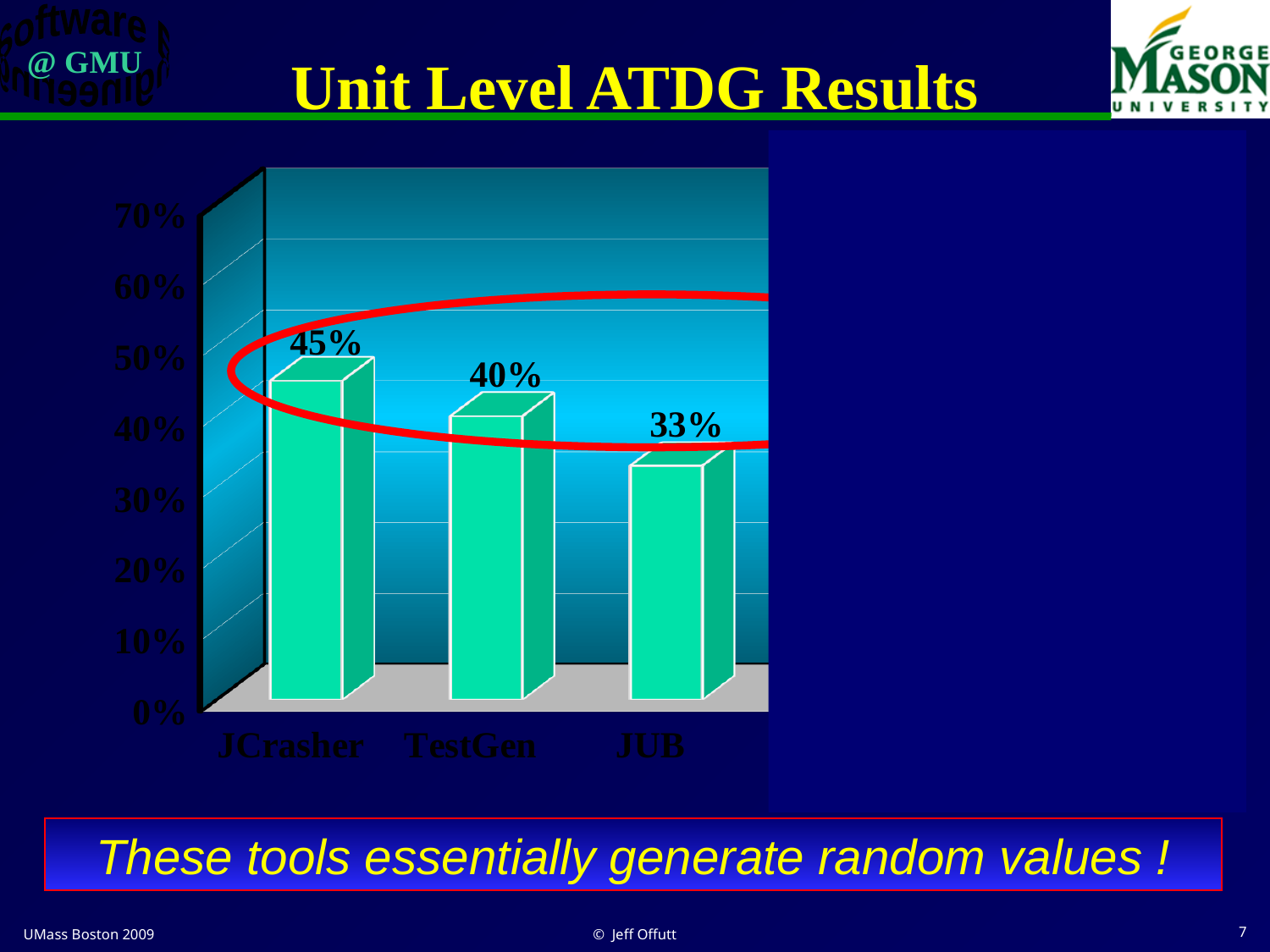
What is the difference between the values for JCrasher and JUB? 12% What is the value for TestGen? 40% What kind of chart is shown on the slide? bar chart Which is larger, the value for TestGen or the value for JUB? TestGen Do the values rise or fall from left to right across the chart? fall Which tool has the lowest value? JUB What is the value for JUB? 33% What is the value for JCrasher? 45% Is the value for JUB greater or less than 40%? less How many tools are shown on the chart? 3 Which tool has the highest value? JCrasher What is the difference between the values for TestGen and JUB? 7%